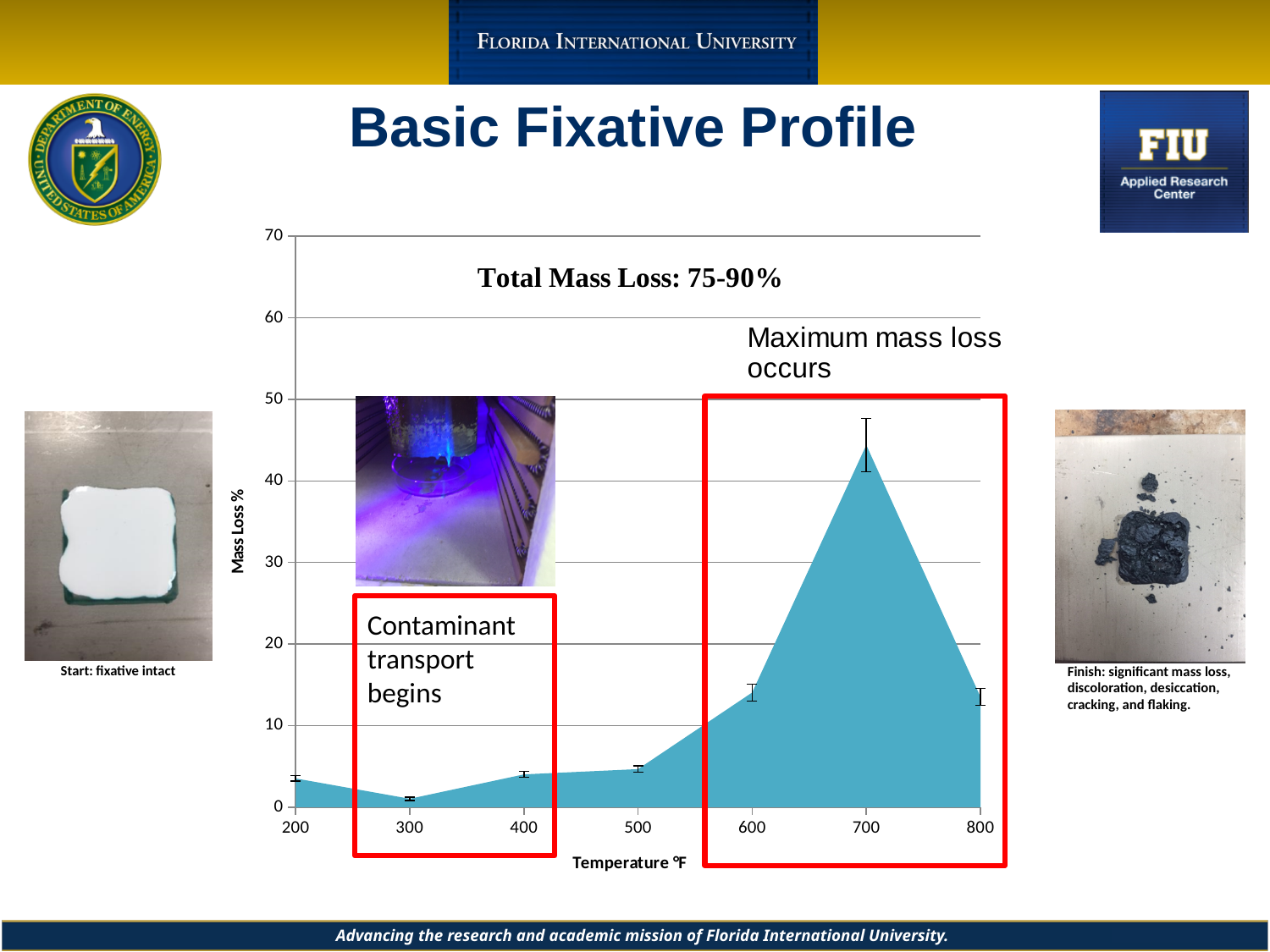
Which has the higher mass loss, 600 °F or 700 °F? 700 °F At which temperature is the mass loss lowest? 300 What total mass loss range is stated in the text at the top of the chart? 75-90% Is the mass loss at 600 °F greater or less than 10%? greater Is the mass loss at 700 °F greater or less than 40%? greater Which has the higher mass loss, 300 °F or 400 °F? 400 °F Does the mass loss rise or fall between 300 °F and 700 °F? Rise What is the title of the x axis? Temperature °F Is the mass loss at 500 °F greater or less than 10%? less At which temperature does the mass loss reach its highest value? 700 What kind of chart is shown on the slide? Area chart How many temperature points are plotted on the x axis? 7